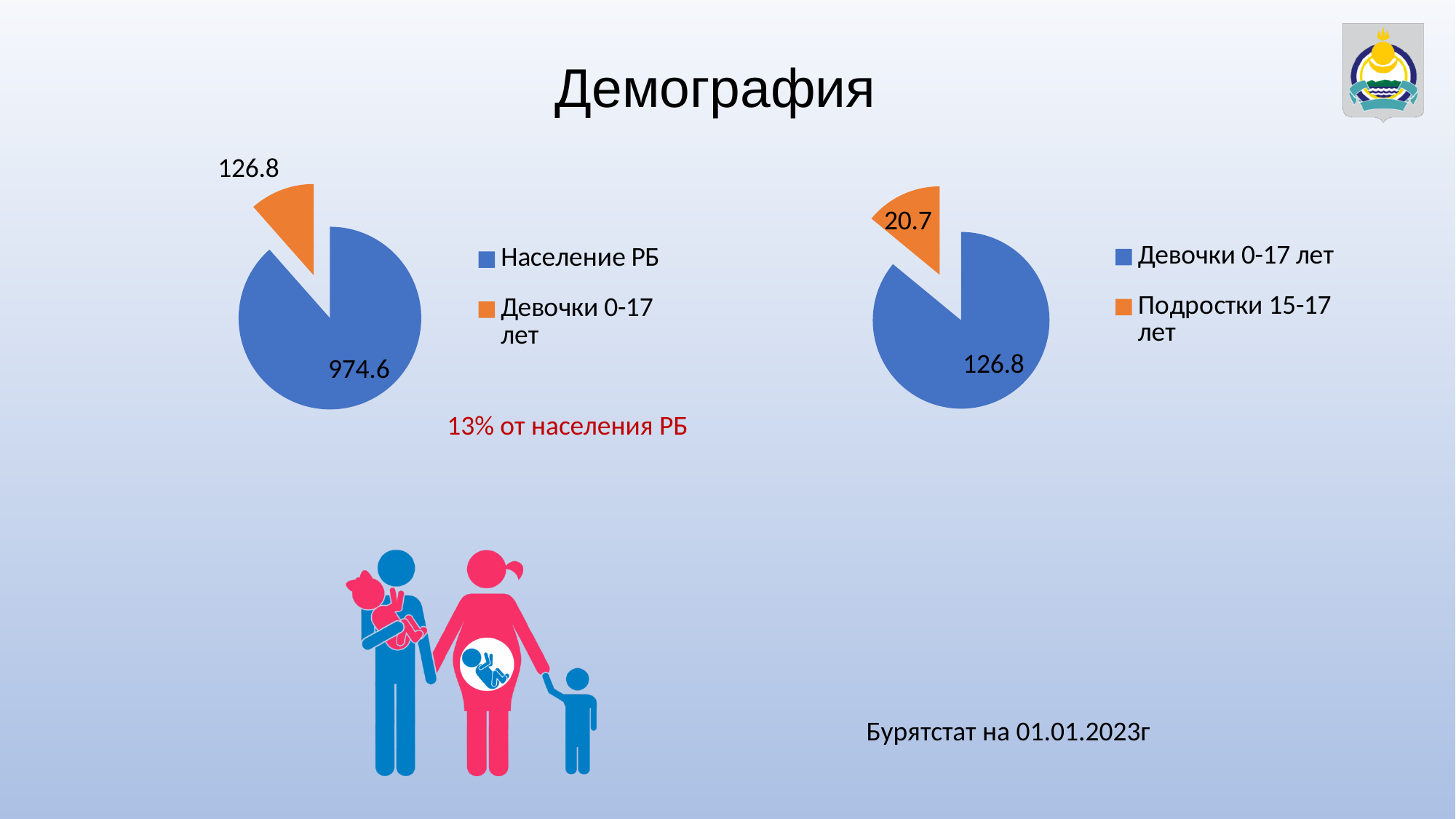
In the right pie chart, what is the difference between Девочки 0-17 лет and Подростки 15-17 лет? 106.1 In the left pie chart, what is the value for Население РБ? 974.6 How many slices does the right pie chart have? 2 In the left pie chart, what is the value for Девочки 0-17 лет? 126.8 What kind of chart is the left chart on the slide? pie chart In the left pie chart, what is the difference between Население РБ and Девочки 0-17 лет? 847.8 In the right pie chart, which slice is the smallest? Подростки 15-17 лет How many entries does the legend of the left pie chart list? 2 In the right pie chart, what is the value for Подростки 15-17 лет? 20.7 What colour is the Подростки 15-17 лет slice in the right pie chart? orange In the left pie chart, which slice is the largest? Население РБ In the right pie chart, what is the value for Девочки 0-17 лет? 126.8